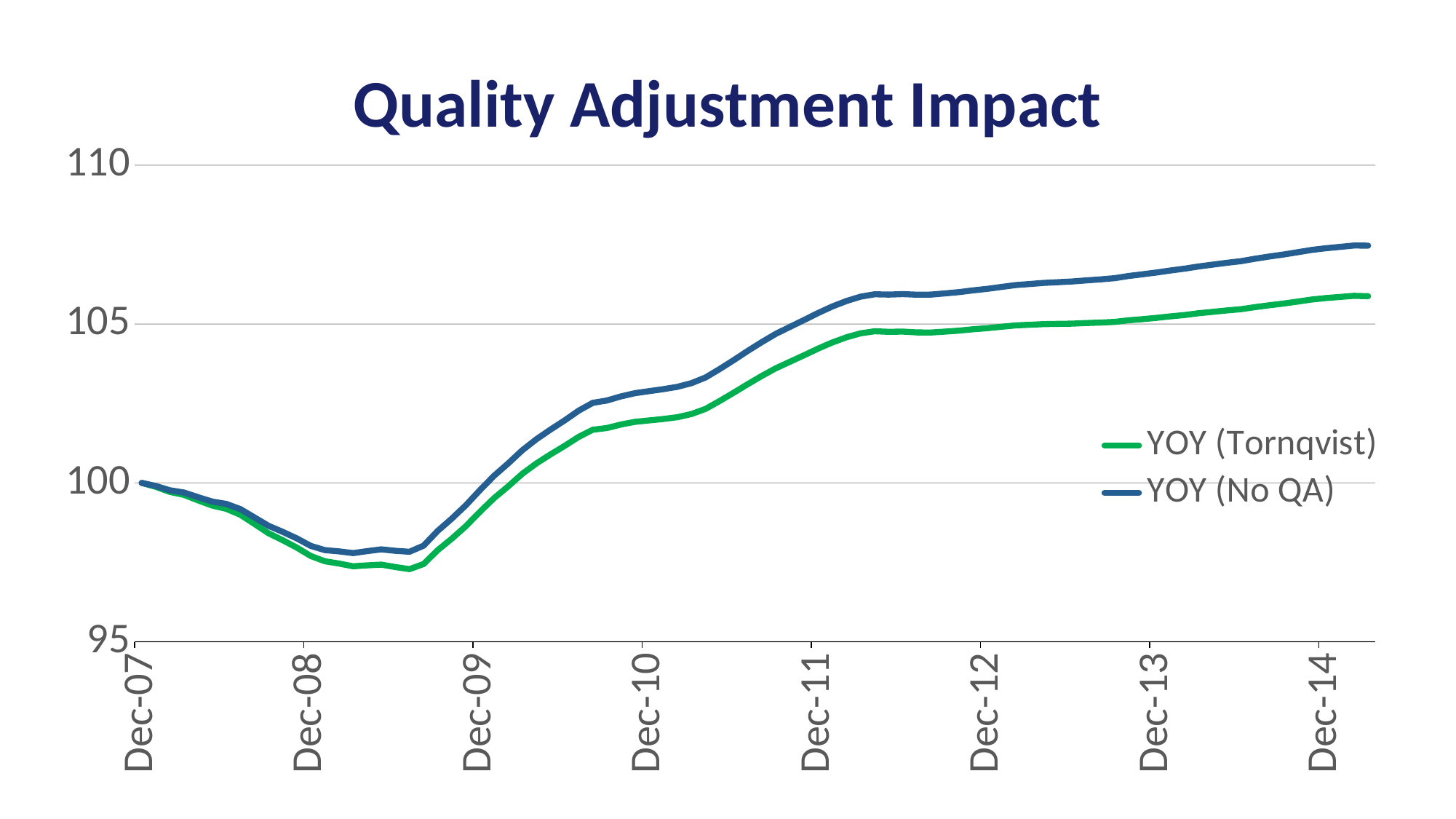
At Dec-14, which series has the higher value, YOY (Tornqvist) or YOY (No QA)? YOY (No QA) Is the value for YOY (No QA) at Dec-14 greater or less than 105? greater What is the value of YOY (No QA) at Dec-07? 100 Is the value for YOY (Tornqvist) at Dec-08 greater or less than 100? less What is the title of the chart? Quality Adjustment Impact What kind of chart is shown on the slide? line chart How many series does the legend list? 2 Do the values of YOY (No QA) rise or fall from Dec-09 to Dec-14? rise How many date labels are shown on the x axis? 8 Is the value for YOY (Tornqvist) at Dec-10 greater or less than 105? less What is the value of YOY (Tornqvist) at Dec-07? 100 Which series is drawn in green? YOY (Tornqvist)